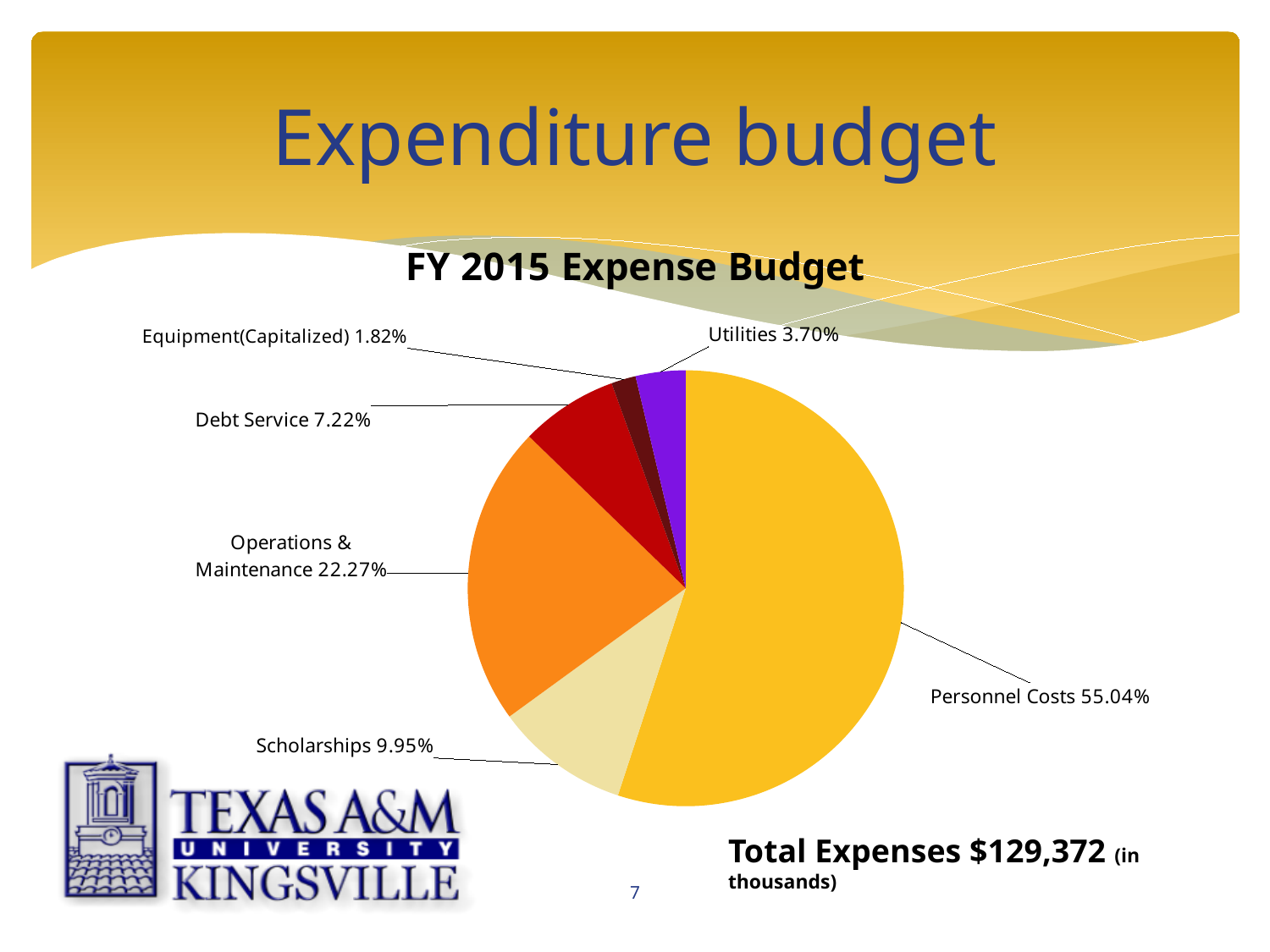
How many categories are shown in the pie chart? 6 Which category has the smallest slice of the pie? Equipment(Capitalized) Which category has the largest slice of the pie? Personnel Costs What type of chart is shown on the slide? Pie chart Which is larger, Debt Service or Utilities? Debt Service What percentage of the pie is Operations & Maintenance? 22.27% What is the title of the pie chart? FY 2015 Expense Budget What percentage is labelled for Debt Service? 7.22% What is the value shown for Scholarships? 9.95% What is the difference in percentage points between Operations & Maintenance and Scholarships? 12.32 What share does Utilities have in the pie chart? 3.70% What share of the FY 2015 Expense Budget is Personnel Costs? 55.04%